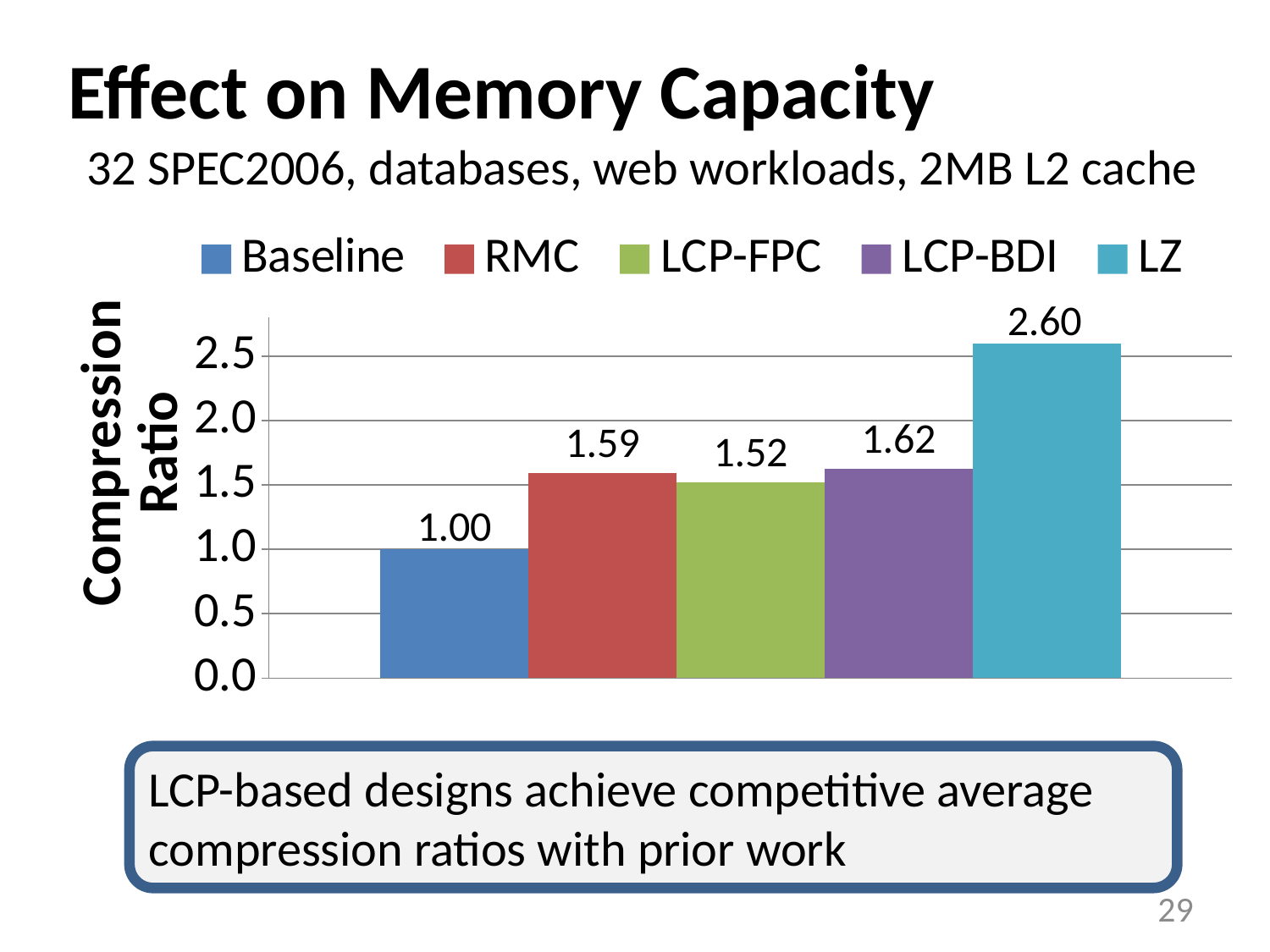
What is the difference between the compression ratios of LCP-BDI and LCP-FPC? 0.10 Which has a larger compression ratio, RMC or LCP-FPC? RMC What is the compression ratio for LCP-BDI? 1.62 Which series has the lowest compression ratio? Baseline What kind of chart is shown on the slide? bar chart What is the difference between the compression ratios of LZ and Baseline? 1.60 What is the compression ratio for RMC? 1.59 Which series has the highest compression ratio? LZ What is the compression ratio for LCP-FPC? 1.52 What is the label of the vertical axis? Compression Ratio Is the compression ratio for LZ greater or less than 2.5? greater How many series does the legend list? 5